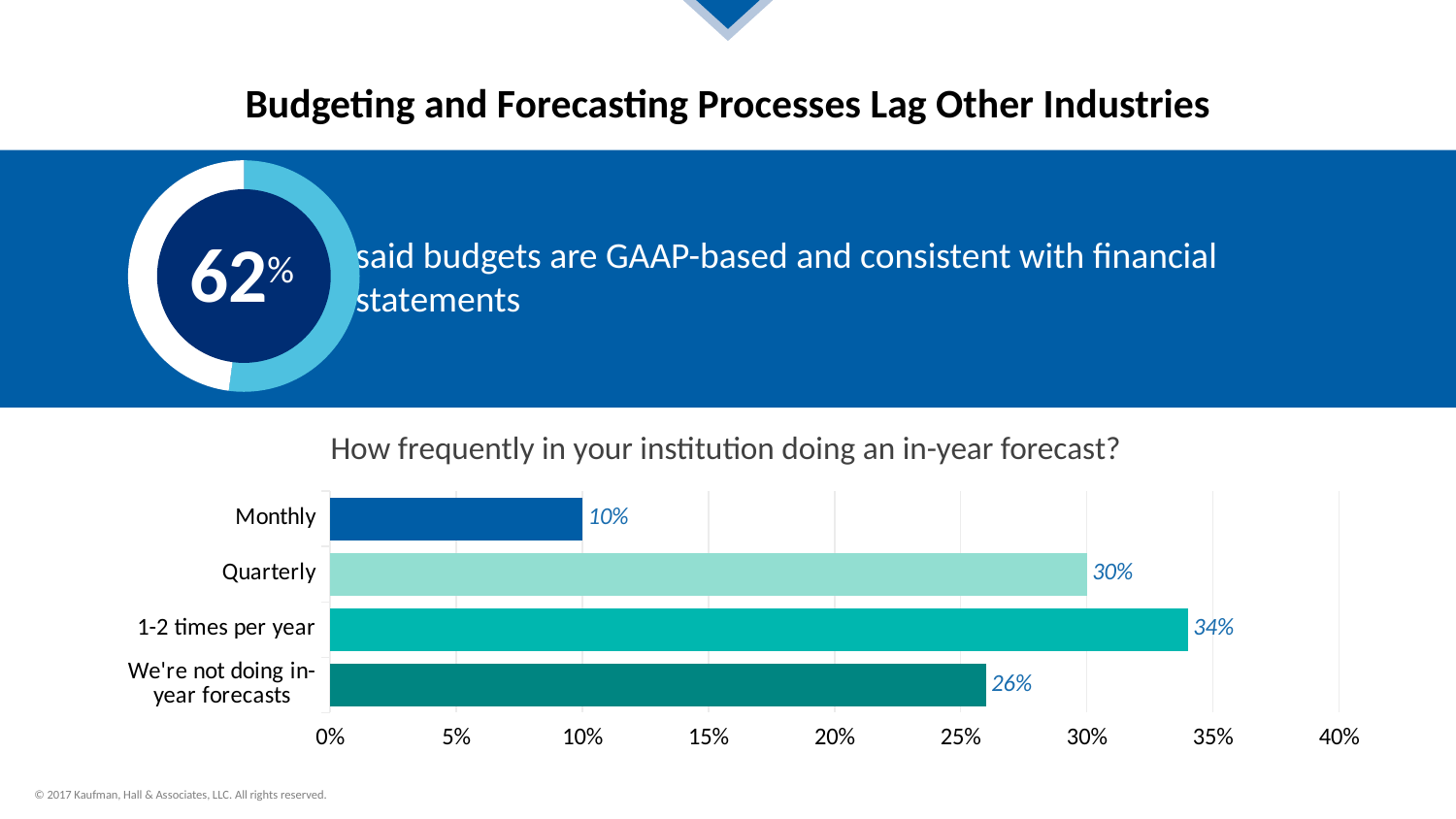
In the bar chart 'How frequently in your institution doing an in-year forecast?', which category has the lowest value? Monthly In the bar chart 'How frequently in your institution doing an in-year forecast?', what is the difference between the values for Quarterly and Monthly? 20% What percentage is shown in the donut graphic at the top of the slide, next to the statement about GAAP-based budgets? 62% In the bar chart 'How frequently in your institution doing an in-year forecast?', what is the value for '1-2 times per year'? 34% In the bar chart 'How frequently in your institution doing an in-year forecast?', which category has the highest value? 1-2 times per year In the bar chart 'How frequently in your institution doing an in-year forecast?', what is the difference between the values for '1-2 times per year' and Quarterly? 4% In the bar chart 'How frequently in your institution doing an in-year forecast?', which is larger: the value for Quarterly or the value for 'We're not doing in-year forecasts'? Quarterly In the bar chart 'How frequently in your institution doing an in-year forecast?', what is the value for 'We're not doing in-year forecasts'? 26% In the bar chart 'How frequently in your institution doing an in-year forecast?', what is the value for Quarterly? 30% In the bar chart 'How frequently in your institution doing an in-year forecast?', what is the value for Monthly? 10% What kind of chart is used for 'How frequently in your institution doing an in-year forecast?'? Bar chart How many categories are shown in the bar chart 'How frequently in your institution doing an in-year forecast?'? 4